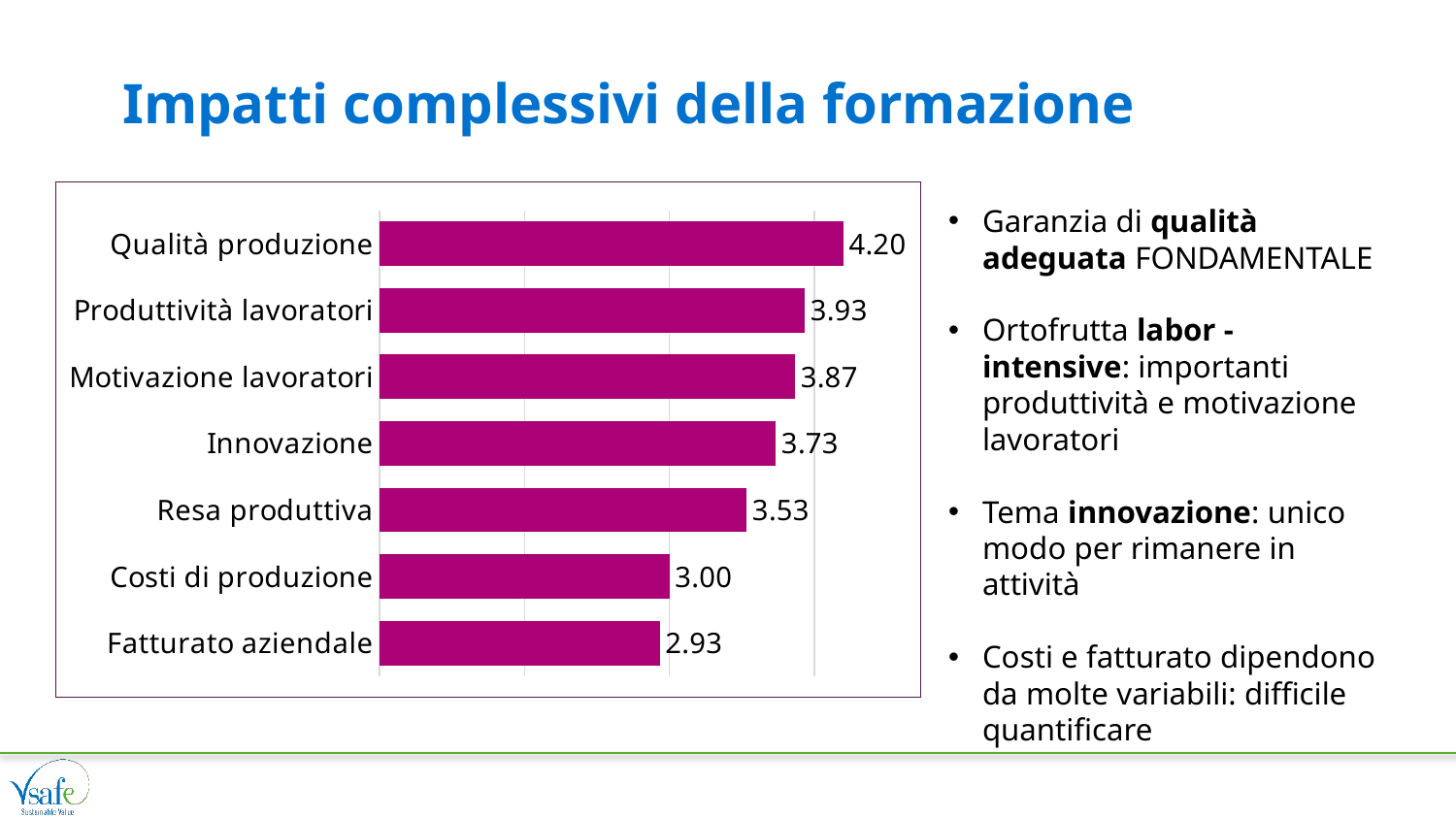
What is the value for Qualità produzione? 4.20 What kind of chart is shown on the slide? Bar chart Which is larger, the value for Innovazione or the value for Resa produttiva? Innovazione What is the difference between the values for Produttività lavoratori and Innovazione? 0.20 What is the value for Resa produttiva? 3.53 How many categories are shown in the chart? 7 Which category has the lowest value? Fatturato aziendale What is the title of the slide containing the chart? Impatti complessivi della formazione Which is larger, the value for Costi di produzione or the value for Motivazione lavoratori? Motivazione lavoratori What is the difference between the values for Qualità produzione and Fatturato aziendale? 1.27 What is the value for Costi di produzione? 3.00 Which category has the highest value? Qualità produzione